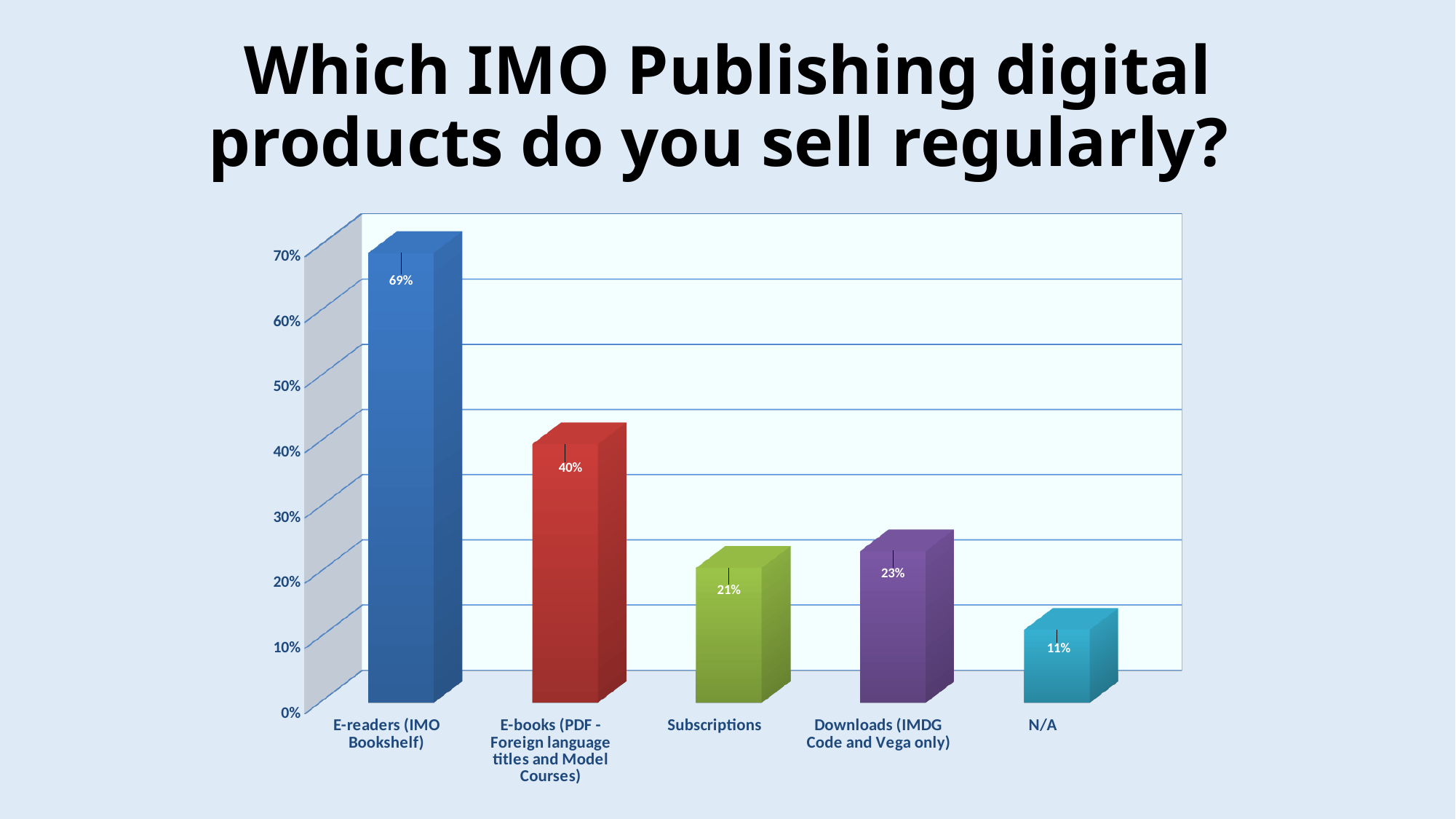
Which category has the highest value? E-readers (IMO Bookshelf) What is the value for Downloads (IMDG Code and Vega only)? 23% Which is larger, the value for Subscriptions or the value for Downloads (IMDG Code and Vega only)? Downloads (IMDG Code and Vega only) What is the value for N/A? 11% What is the value for E-readers (IMO Bookshelf)? 69% What is the title of the slide? Which IMO Publishing digital products do you sell regularly? What is the difference between the values for E-readers (IMO Bookshelf) and E-books (PDF - Foreign language titles and Model Courses)? 29% What kind of chart is shown on the slide? Bar chart What is the value for E-books (PDF - Foreign language titles and Model Courses)? 40% Which category has the lowest value? N/A What is the value for Subscriptions? 21% How many categories are shown on the chart? 5